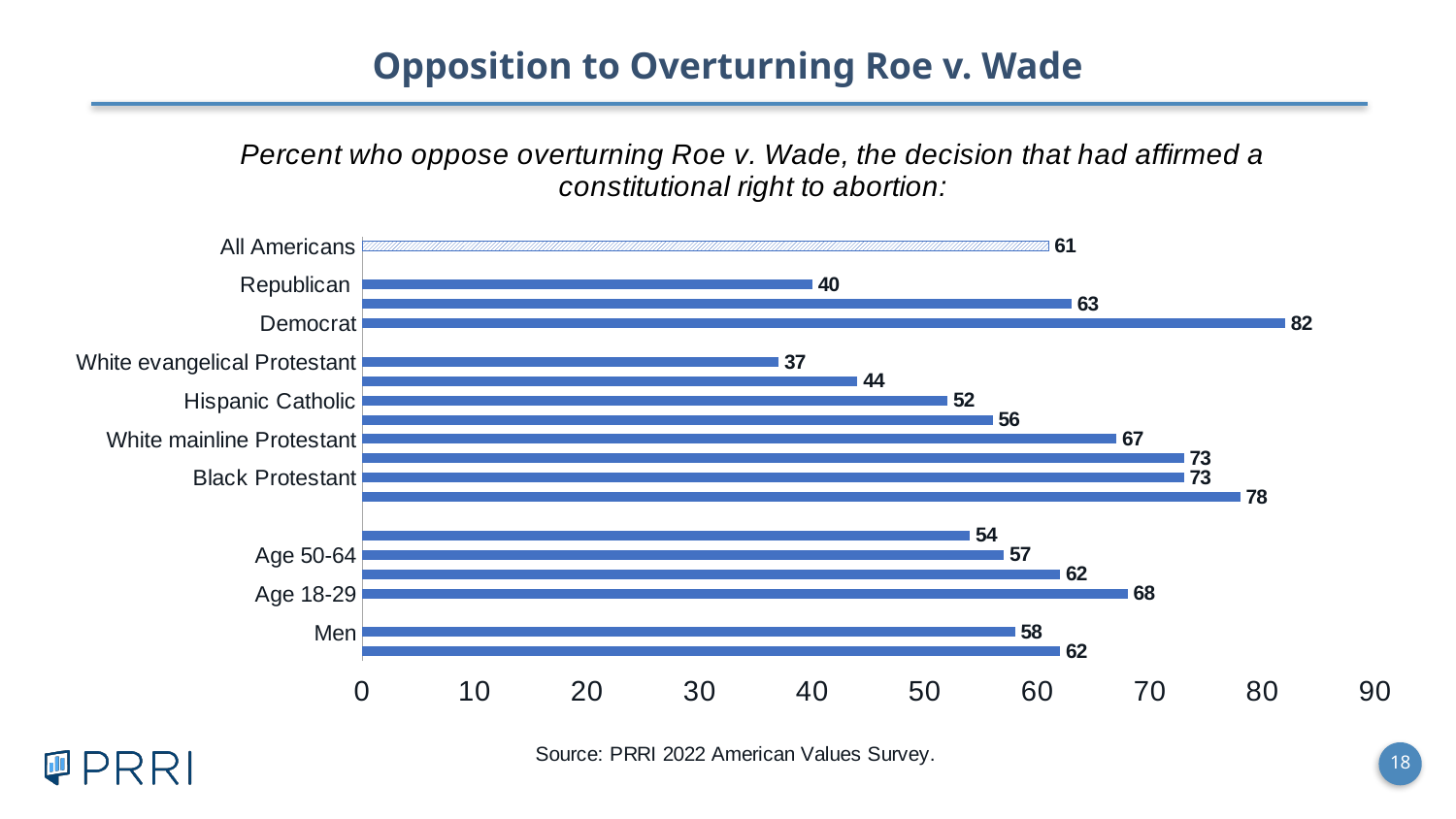
What percent of Democrats oppose overturning Roe v. Wade? 82 What is the value shown for White evangelical Protestant? 37 Which is larger, the value for Black Protestant or the value for White mainline Protestant? Black Protestant What is the value shown for Republican? 40 Which labeled group has the highest value on the chart? Democrat What kind of chart is shown on the slide? Bar chart What is the value shown for Age 18-29? 68 What is the value shown for All Americans? 61 Which labeled group has the lowest value on the chart? White evangelical Protestant What is the difference between the values for Democrat and Republican? 42 What is the title of the slide? Opposition to Overturning Roe v. Wade Is the value for Hispanic Catholic greater or less than 60? less